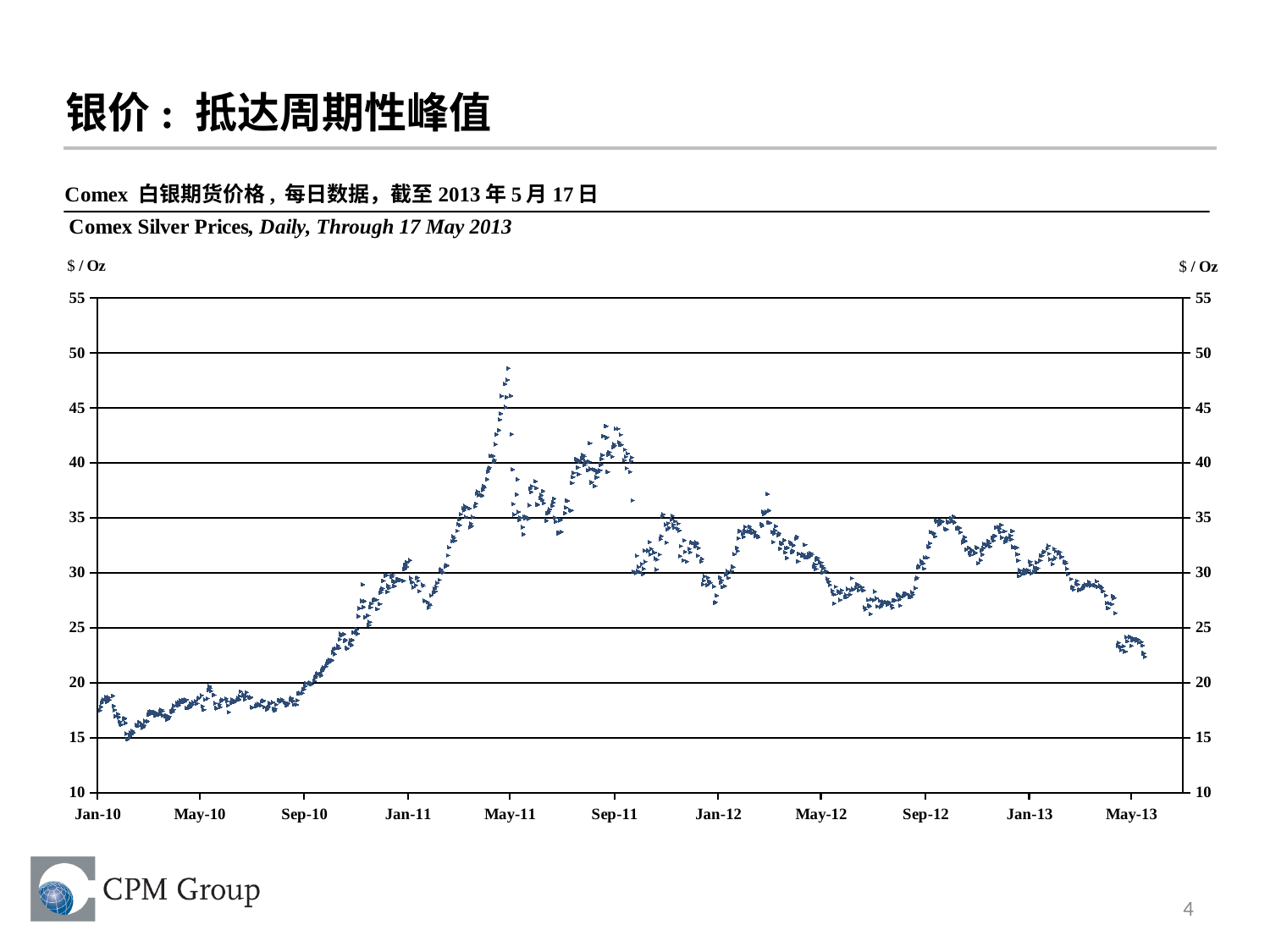
Is the silver price at May-13 greater or less than 25? less What kind of chart is shown on the slide? scatter chart Is the silver price at Jan-10 greater or less than 20? less What is the English title of the chart? Comex Silver Prices, Daily, Through 17 May 2013 How many date labels are shown on the x axis? 11 Is the peak silver price reached around May-11 greater or less than 45? greater What unit is shown on the y axis of the chart? $ / Oz Does the silver price rise or fall between Sep-10 and May-11? rise Does the silver price rise or fall overall between May-11 and May-13? fall Near which x-axis label does the silver price reach its highest point? May-11